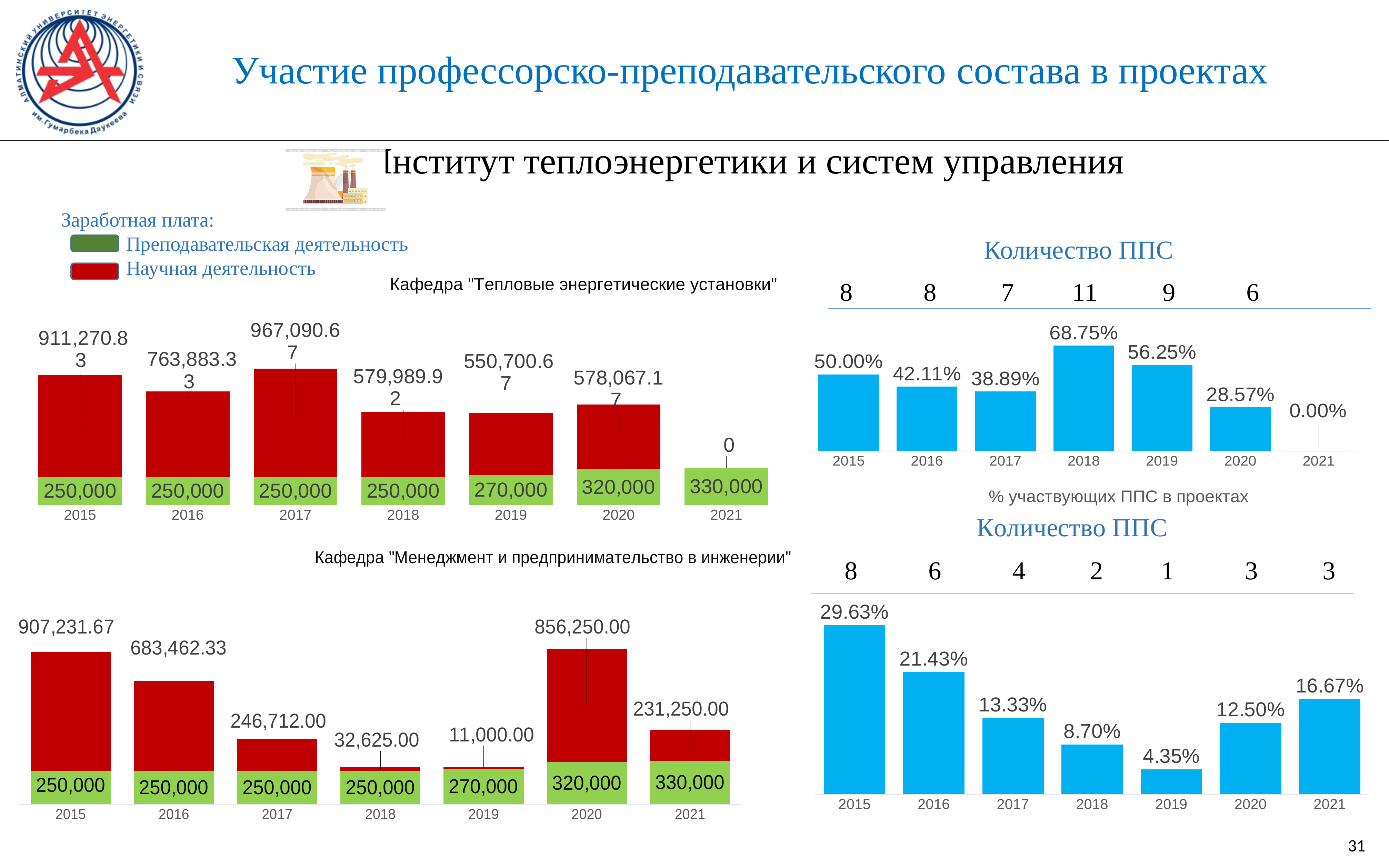
In the top-left chart (Кафедра "Тепловые энергетические установки"), what is the total of the stacked bar for 2015? 1,161,270.83 In the top-left chart (Кафедра "Тепловые энергетические установки"), what is the value of Научная деятельность for 2017? 967,090.67 How many series does the legend for the left-hand stacked bar charts list? 2 In the bottom-left chart (Кафедра "Менеджмент и предпринимательство в инженерии"), which year has the lowest Научная деятельность value? 2019 In the bottom-left chart (Кафедра "Менеджмент и предпринимательство в инженерии"), what is the total of the stacked bar for 2020? 1,176,250.00 In the top-right chart (% участвующих ППС в проектах), what is the value for 2018? 68.75% In the bottom-right chart (% участвующих ППС в проектах), which year has the highest value? 2015 In the top-left chart (Кафедра "Тепловые энергетические установки"), which year has the highest Научная деятельность value? 2017 In the top-right chart (% участвующих ППС в проектах), what is the difference between the values for 2018 and 2019? 12.50% In the bottom-right chart (% участвующих ППС в проектах), which is larger: the value for 2020 or the value for 2021? 2021 In the top-left chart (Кафедра "Тепловые энергетические установки"), what is the value of Преподавательская деятельность for 2020? 320,000 In the bottom-left chart (Кафедра "Менеджмент и предпринимательство в инженерии"), what is the value of Научная деятельность for 2019? 11,000.00